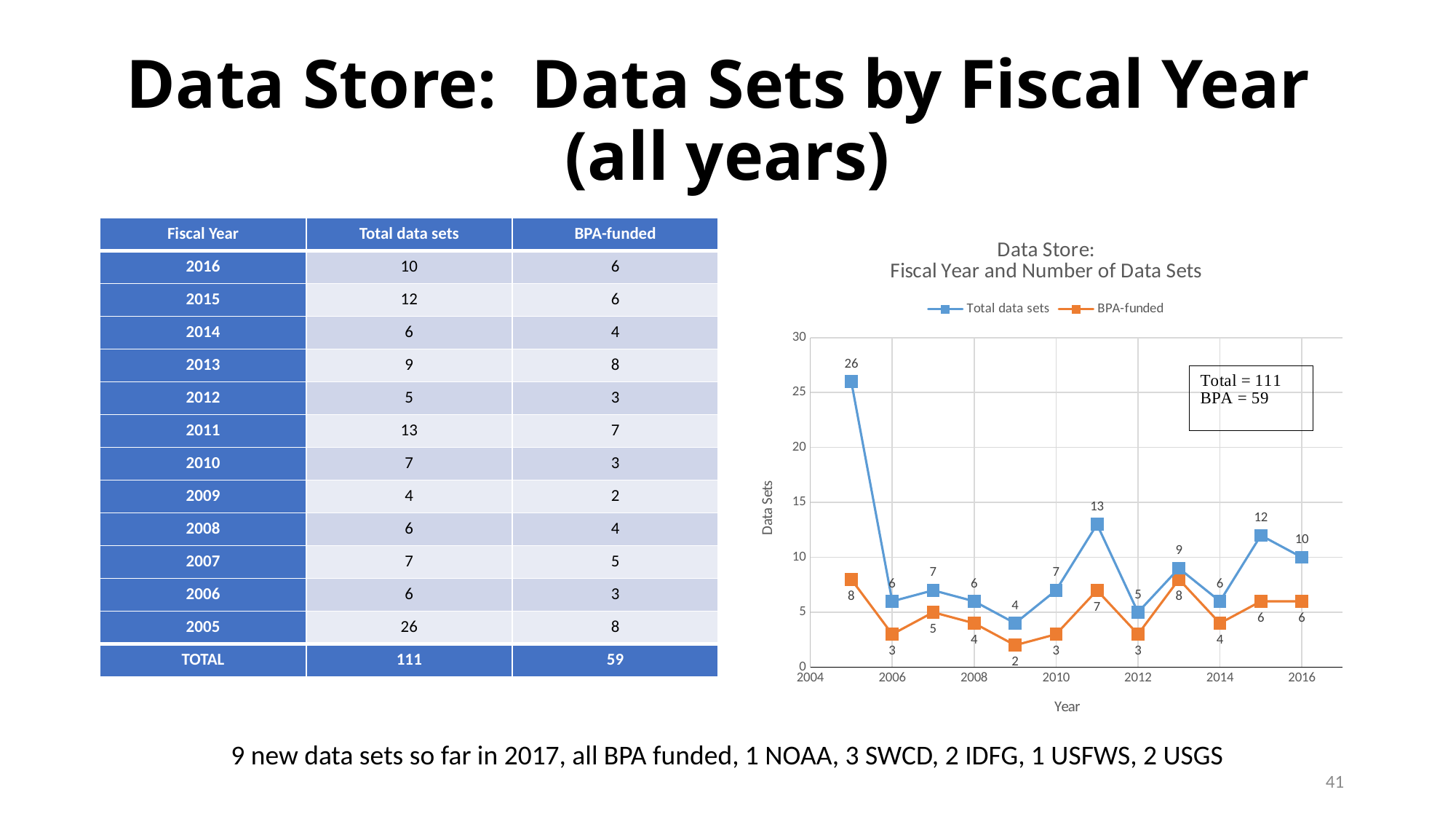
What type of chart is shown on the slide? line chart Does the Total data sets series rise or fall from 2005 to 2006? fall What is the value for Total data sets in 2011? 13 What is the value for BPA-funded in 2013? 8 How many series does the chart legend list? 2 Which is larger, Total data sets in 2015 or Total data sets in 2016? 2015 What is the title of the chart? Data Store: Fiscal Year and Number of Data Sets What is the value for Total data sets in 2005? 26 Which year has the highest value for Total data sets? 2005 How many years are plotted on the chart? 12 Which year has the lowest value for BPA-funded? 2009 What is the difference between Total data sets and BPA-funded in 2011? 6